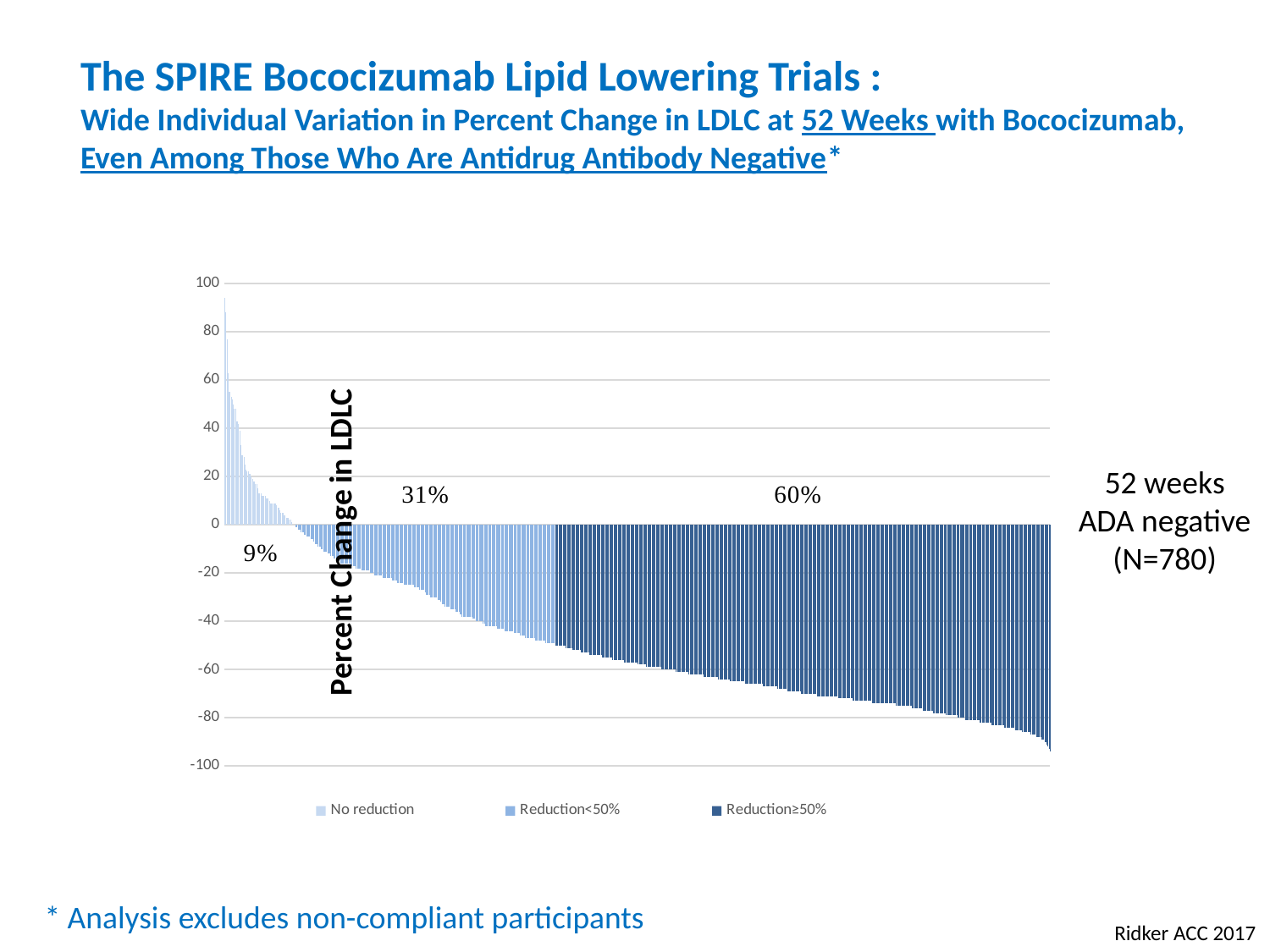
What is the difference between the labelled shares for Reduction≥50% and Reduction<50%? 29% What percentage of participants is labelled for the No reduction group? 9% What kind of chart is shown on the slide? bar chart How many series does the legend list? 3 What is the label on the vertical axis of the chart? Percent Change in LDLC Is the value of the tallest positive bar greater or less than 80? greater Which group has the largest labelled share of participants? Reduction≥50% What percentage of participants is labelled for the Reduction≥50% group? 60% Which group has the smallest labelled share of participants? No reduction Do the bar values rise or fall moving from left to right along the x axis? fall What percentage of participants is labelled for the Reduction<50% group? 31% What are the three legend entries of the chart? No reduction, Reduction<50%, Reduction≥50%